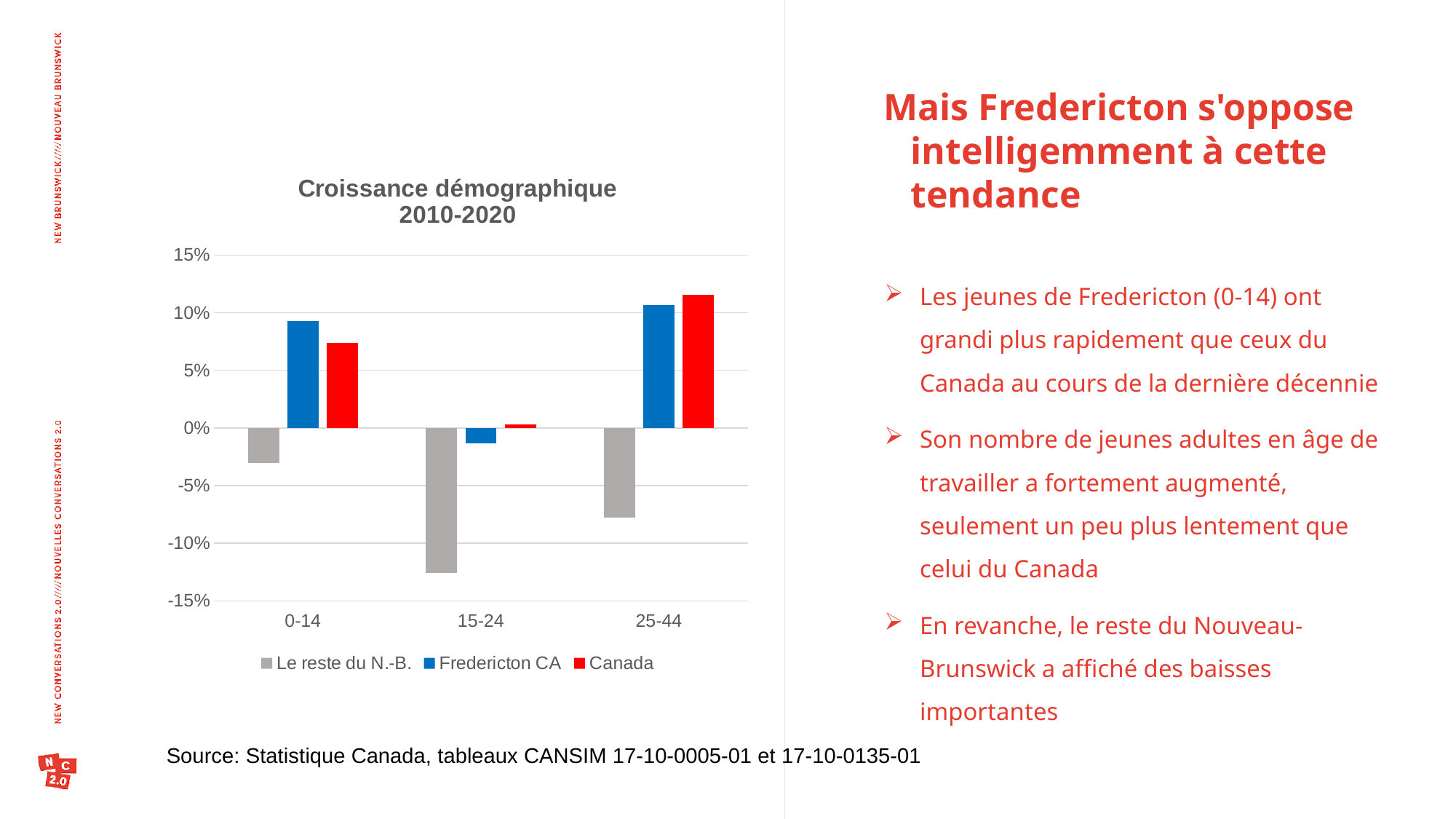
What colour represents the Canada series in the chart? red How many series does the legend of the chart list? 3 How many age-group categories are shown on the x axis of the chart? 3 Is the value for Le reste du N.-B. in the 15-24 category greater or less than -10%? less What kind of chart is shown on the slide? bar chart What is the title of the chart? Croissance démographique 2010-2020 Is the value for Canada in the 25-44 category greater or less than 10%? greater Is the value for Le reste du N.-B. in the 25-44 category greater or less than -5%? less For the series Fredericton CA, which category has the highest value? 25-44 In the 0-14 category, which is larger: the value for Fredericton CA or the value for Canada? Fredericton CA For the series Le reste du N.-B., which category has the lowest value? 15-24